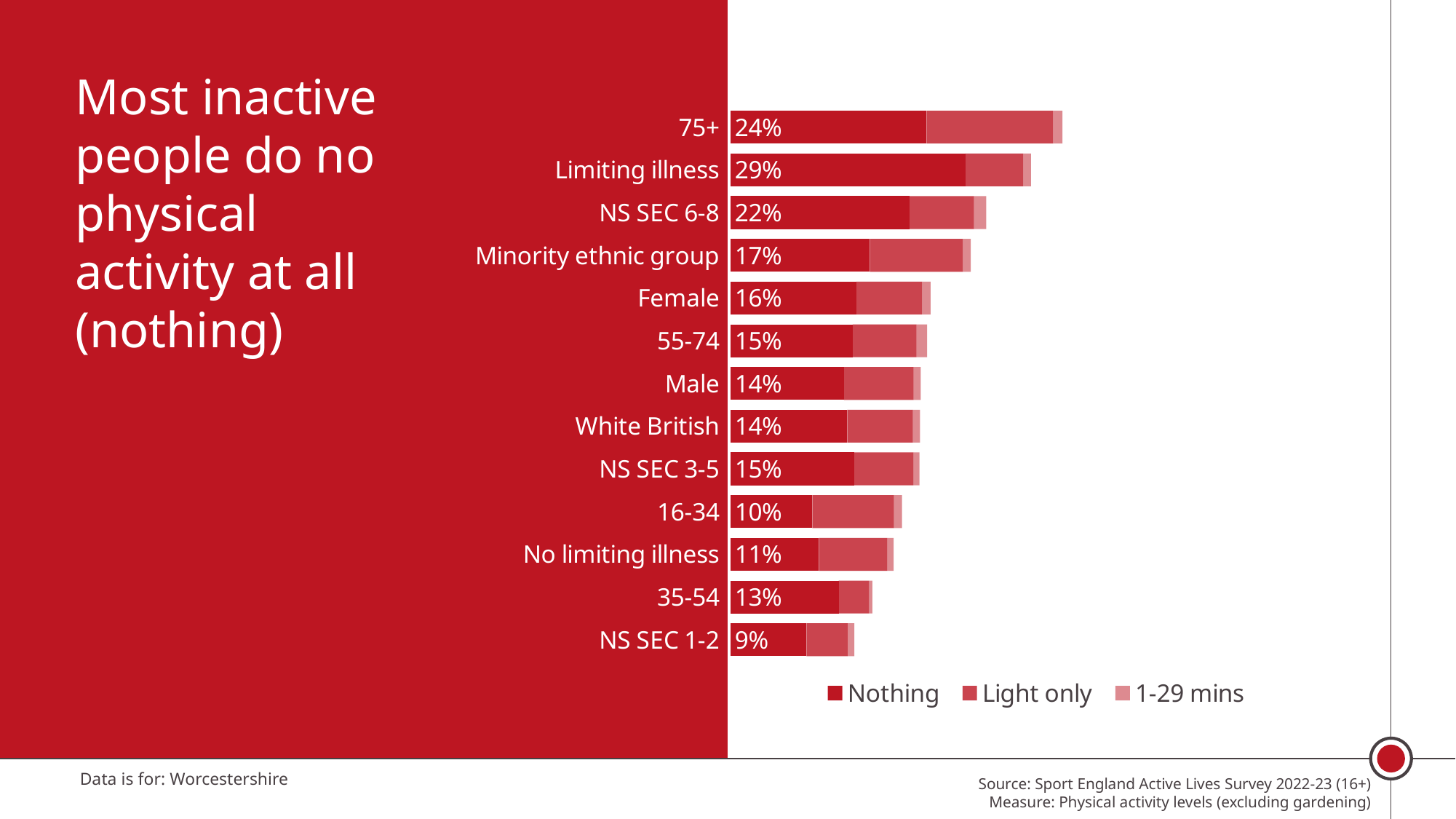
Which has a higher 'Nothing' percentage, Female or Male? Female Which category has the highest 'Nothing' percentage? Limiting illness Which category has the lowest 'Nothing' percentage? NS SEC 1-2 How many series does the legend list? 3 What percentage of people with a limiting illness do nothing? 29% What is the difference in the 'Nothing' percentage between Limiting illness and No limiting illness? 18 percentage points What kind of chart is shown on the slide? Stacked bar chart What is the 'Nothing' value for the 75+ group? 24% How many categories are shown on the chart? 13 What is the 'Nothing' value for NS SEC 1-2? 9% What is the 'Nothing' value for the Minority ethnic group? 17% What are the three series named in the legend? Nothing, Light only, 1-29 mins